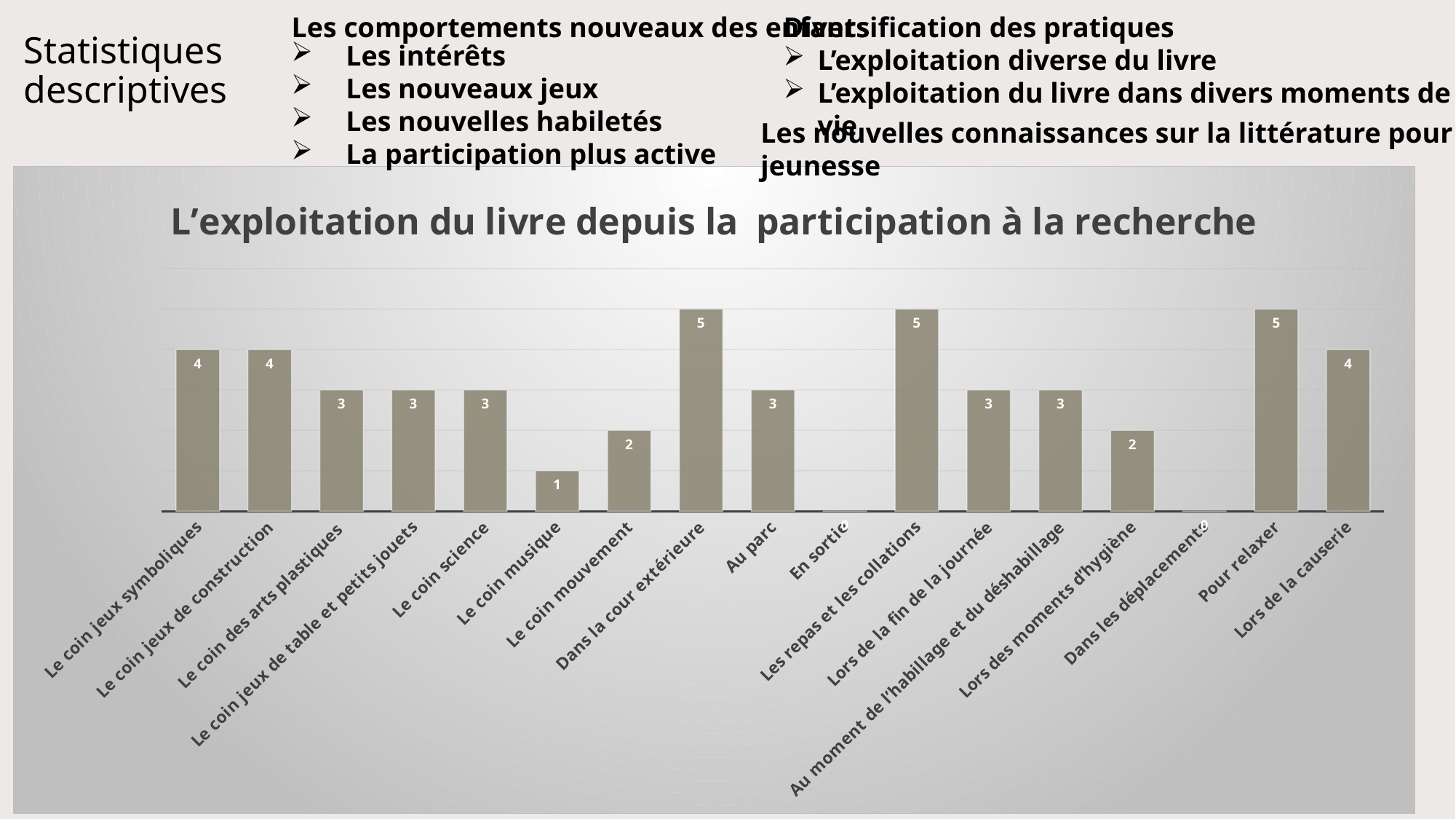
What is the value for 'En sortie'? 0 Which has a larger value, 'Les repas et les collations' or 'Au parc'? Les repas et les collations What is the difference between the values for 'Pour relaxer' and 'Le coin mouvement'? 3 How many categories are shown on the x axis of the chart? 17 Which has a larger value, 'Le coin jeux symboliques' or 'Le coin science'? Le coin jeux symboliques What kind of chart is shown on the slide? Bar chart What is the title of the chart? L'exploitation du livre depuis la participation à la recherche What is the value for 'Le coin musique'? 1 What is the value for 'Dans la cour extérieure'? 5 What is the highest value shown by any bar in the chart? 5 What is the value for 'Lors des moments d'hygiène'? 2 What is the value for 'Lors de la causerie'? 4